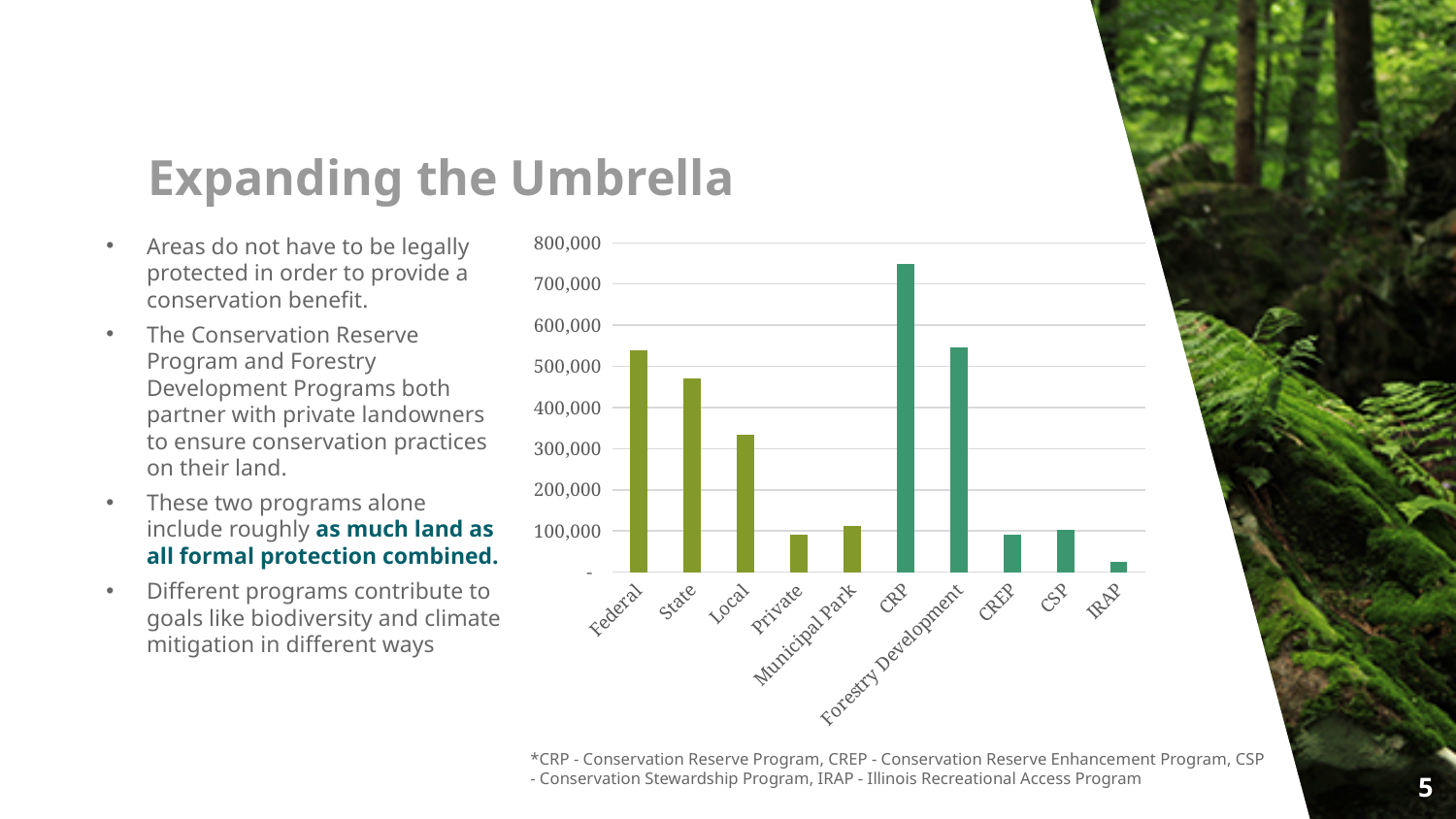
What is the highest value shown on the vertical axis of the chart? 800,000 Which category has the highest value on the chart? CRP How many categories are plotted on the chart? 10 Is the value for CRP greater or less than 700,000? greater Is the value for Local greater or less than 300,000? greater Which is larger, the value for State or the value for Local? State Which is larger, the value for CRP or the value for Forestry Development? CRP What kind of chart is shown on the slide? bar chart Is the value for Federal greater or less than 500,000? greater Which category has the lowest value on the chart? IRAP